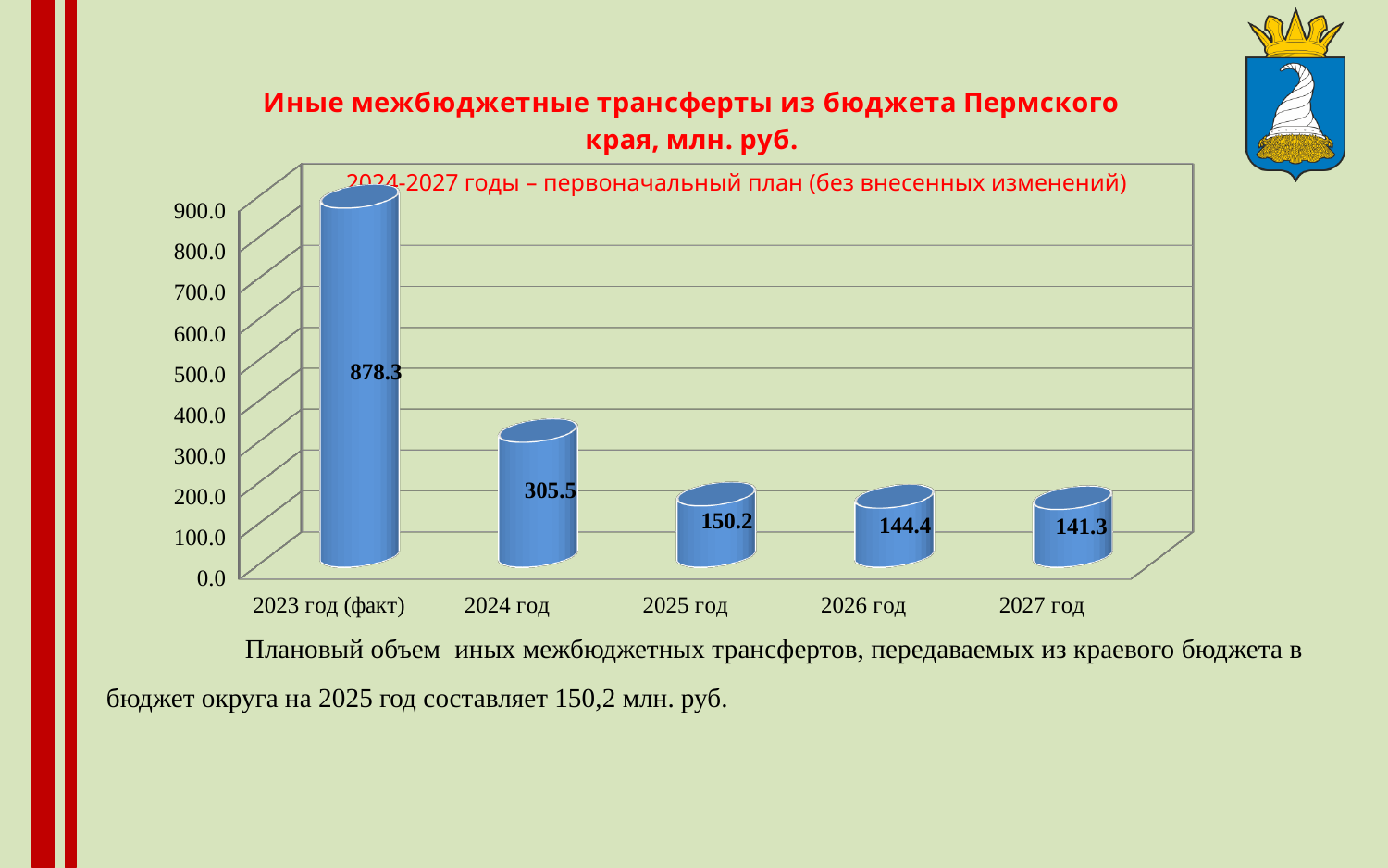
What is the value for 2027 год? 141.3 What is the difference between the values for 2025 год and 2026 год? 5.8 What is the value for 2023 год (факт)? 878.3 Which category has the lowest value? 2027 год What is the value for 2025 год? 150.2 How many categories are shown on the x axis? 5 Do the values rise or fall from 2023 год (факт) to 2027 год? fall Which category has the highest value? 2023 год (факт) What is the difference between the values for 2023 год (факт) and 2024 год? 572.8 Is the value for 2024 год greater or less than 400.0? less What kind of chart is shown on the slide? bar chart Which is larger, the value for 2024 год or the value for 2025 год? 2024 год